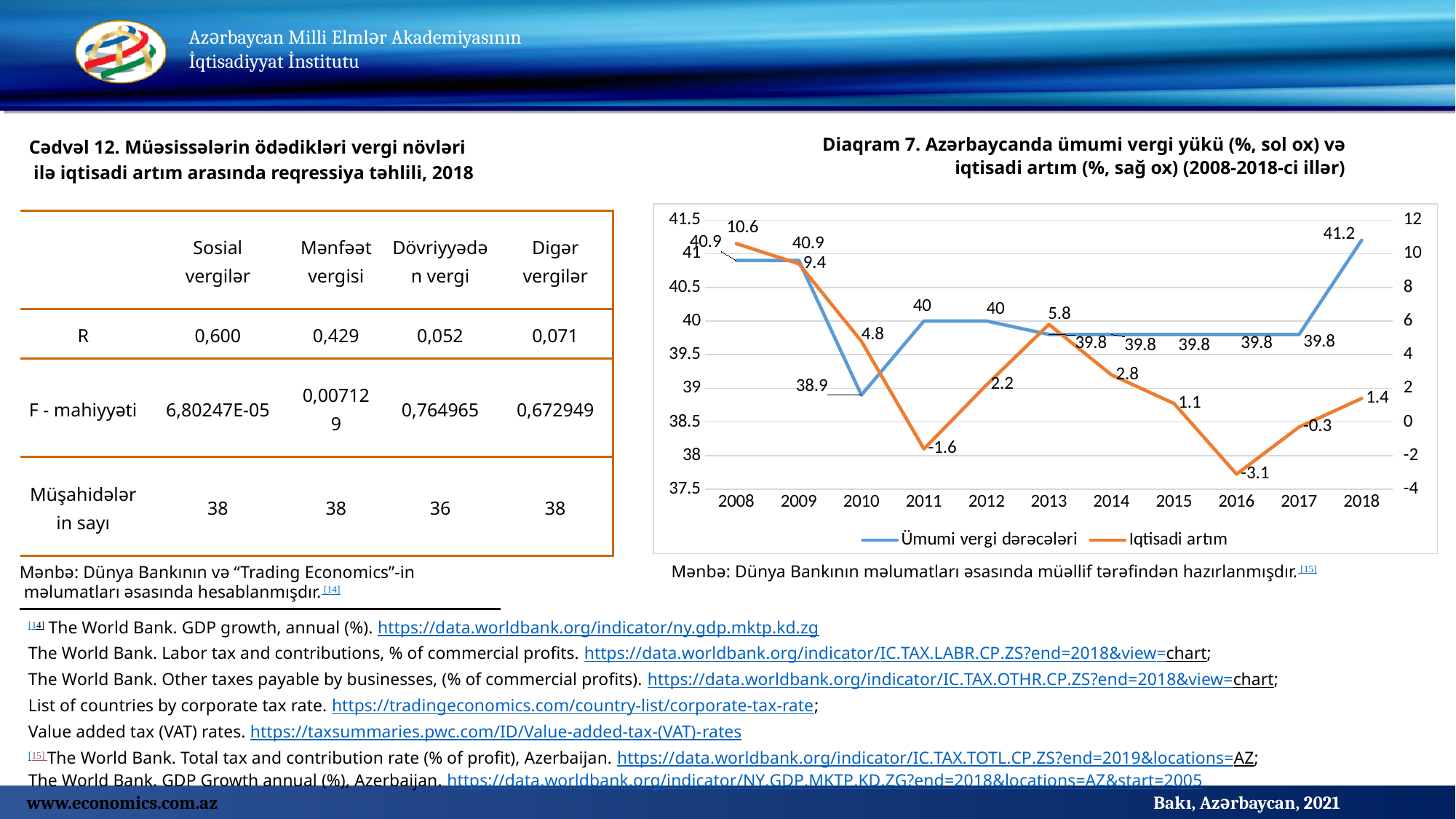
In Diaqram 7, which year has the lowest value for Ümumi vergi dərəcələri? 2010 In Diaqram 7, what is the value of Iqtisadi artım in 2016? -3.1 In Diaqram 7, which year has the highest value for Ümumi vergi dərəcələri? 2018 How many series does the legend of Diaqram 7 list? 2 What type of chart is Diaqram 7? line chart How many years are plotted on the x axis of Diaqram 7? 11 In Diaqram 7, what is the value of Ümumi vergi dərəcələri in 2010? 38.9 In Diaqram 7, is the Iqtisadi artım value larger in 2012 or in 2014? 2014 In Diaqram 7, what is the difference between the Iqtisadi artım values for 2008 and 2009? 1.2 In Diaqram 7, does Iqtisadi artım rise or fall from 2008 to 2011? fall In Diaqram 7, which year has the highest value for Iqtisadi artım? 2008 In Diaqram 7, what is the value of Iqtisadi artım in 2013? 5.8